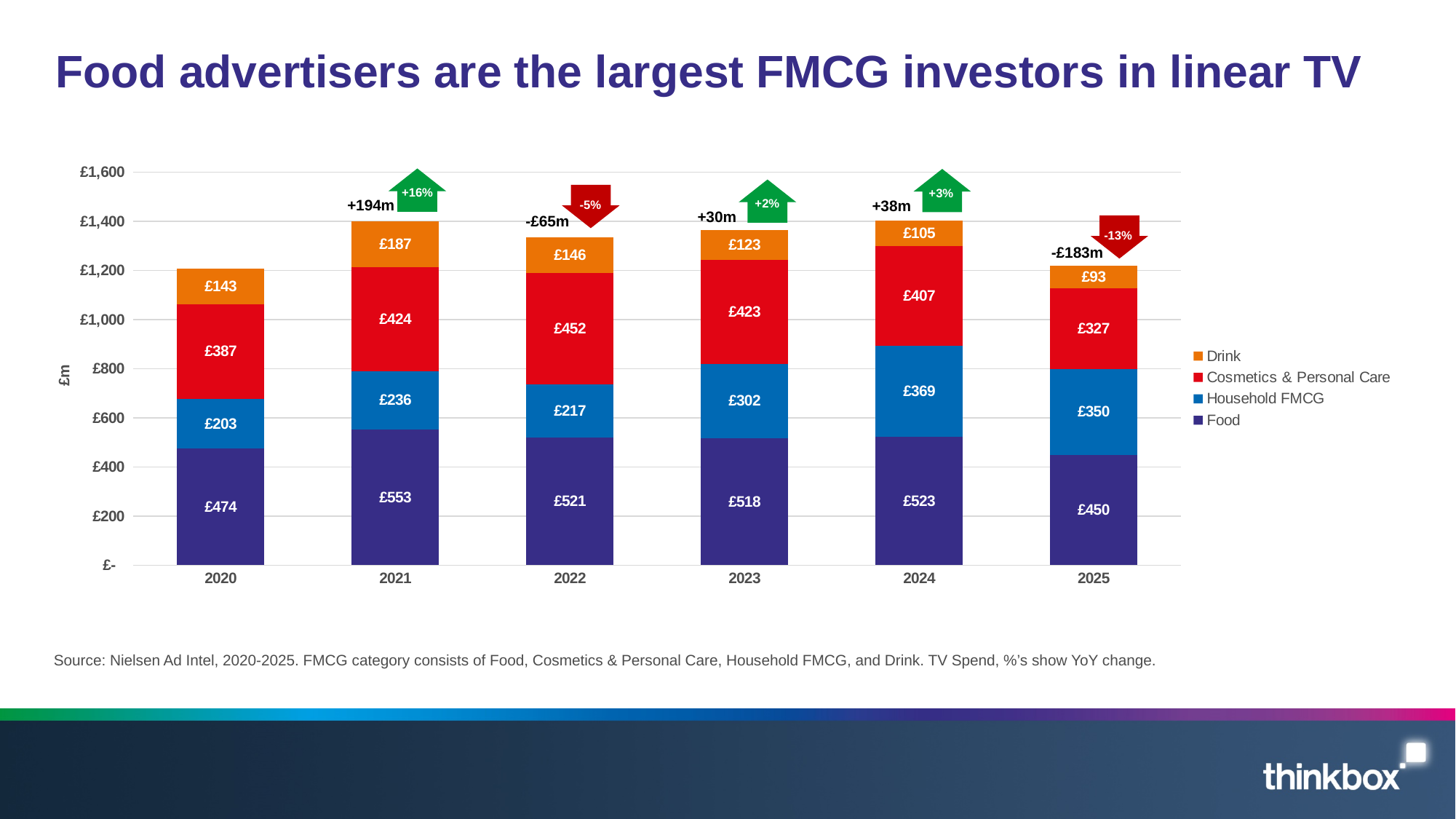
How many series does the legend list? 4 In which year was the Cosmetics & Personal Care spend highest? 2022 What is the difference between the Food spend in 2021 and in 2025? £103 What was the Drink spend in 2025? £93 In which year was the Drink spend lowest? 2025 How many years are shown on the x axis? 6 What was the Household FMCG spend in 2024? £369 What year-on-year percentage change is shown above the 2025 bar? -13% What kind of chart is shown on the slide? Stacked bar chart What was the Food spend in 2021? £553 Which was larger in 2023: Household FMCG spend or Cosmetics & Personal Care spend? Cosmetics & Personal Care What is the total of the stacked bar for 2020? £1,207